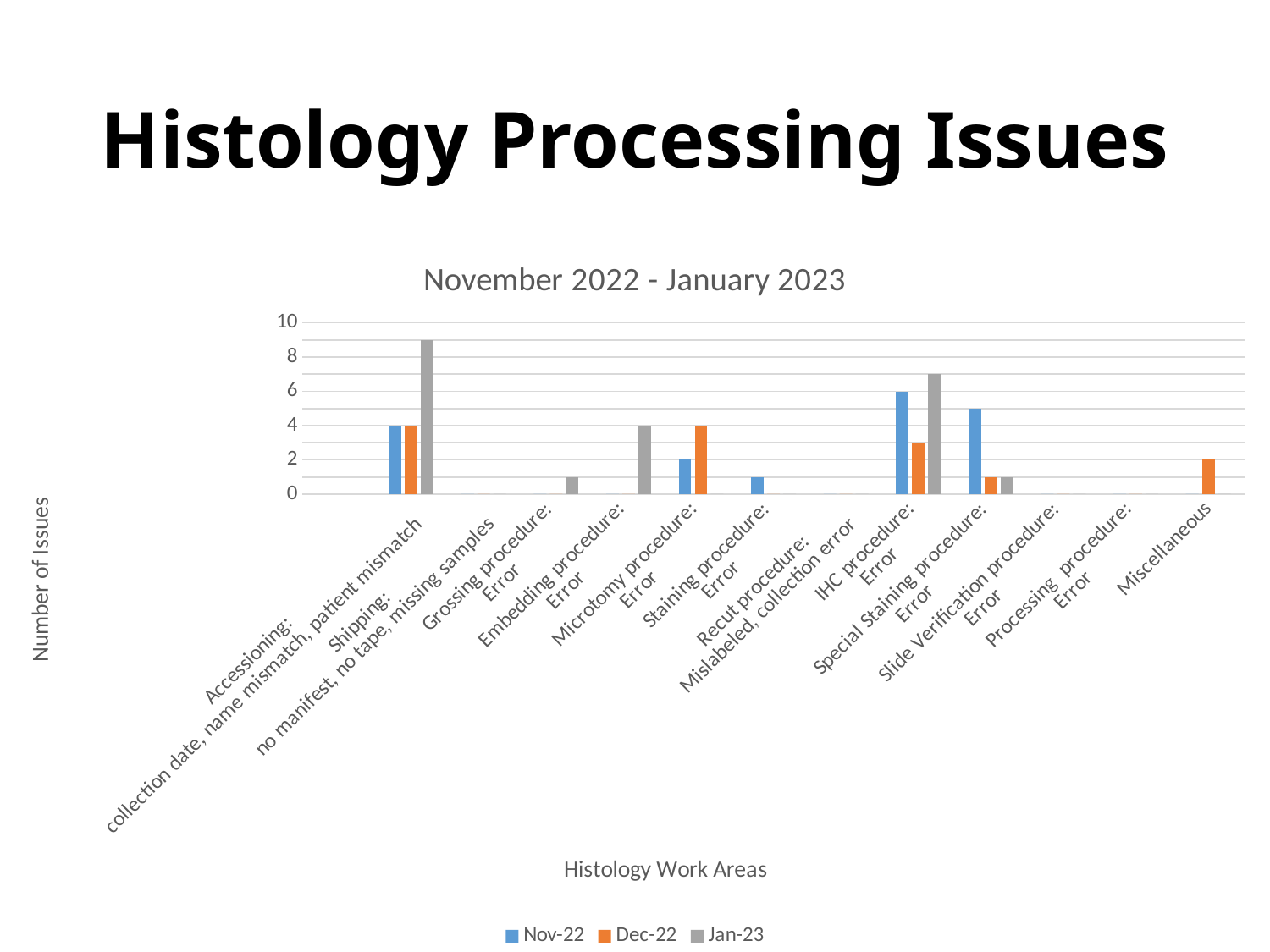
How many histology work area categories are shown on the x axis? 12 Is the Jan-23 value for Accessioning greater or less than 8? greater What is the Nov-22 value for IHC procedure: Error? 6 How many series does the legend list? 3 Which category has the tallest bar in the chart? Accessioning What is the Dec-22 value for Miscellaneous? 2 Which is larger, the Nov-22 value for IHC procedure: Error or the Nov-22 value for Accessioning? IHC procedure: Error Is the Nov-22 value for Special Staining procedure: Error greater or less than 4? greater What is the difference between the Nov-22 values for Accessioning and Microtomy procedure: Error? 2 What is the Dec-22 value for Microtomy procedure: Error? 4 What is the Nov-22 value for Accessioning? 4 What kind of chart is shown on the slide? bar chart